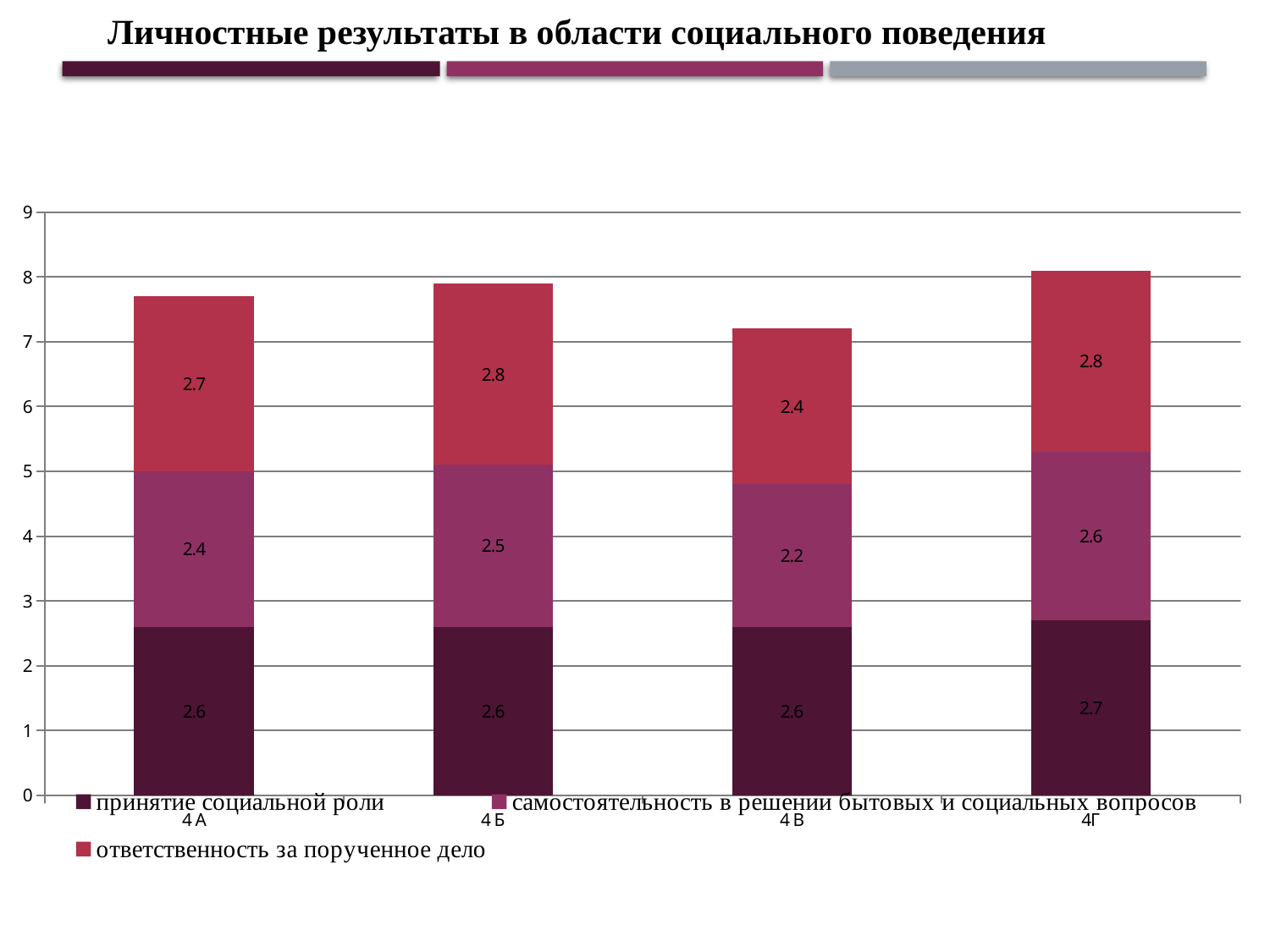
What is the difference between the 'ответственность за порученное дело' values for 4Б and 4В? 0.4 What is the value of 'принятие социальной роли' for 4Г? 2.7 Which class has the lowest value for 'самостоятельность в решении бытовых и социальных вопросов'? 4В How many series does the legend list? 3 What type of chart is shown on the slide? stacked bar chart What is the total of the stacked bar for 4В? 7.2 Which class has the highest value for 'самостоятельность в решении бытовых и социальных вопросов'? 4Г What is the value of 'самостоятельность в решении бытовых и социальных вопросов' for 4В? 2.2 Which is larger: 'ответственность за порученное дело' for 4А or for 4В? 4А What is the total of the stacked bar for 4Г? 8.1 What is the value of 'ответственность за порученное дело' for 4Б? 2.8 How many classes (categories) are shown on the x axis? 4